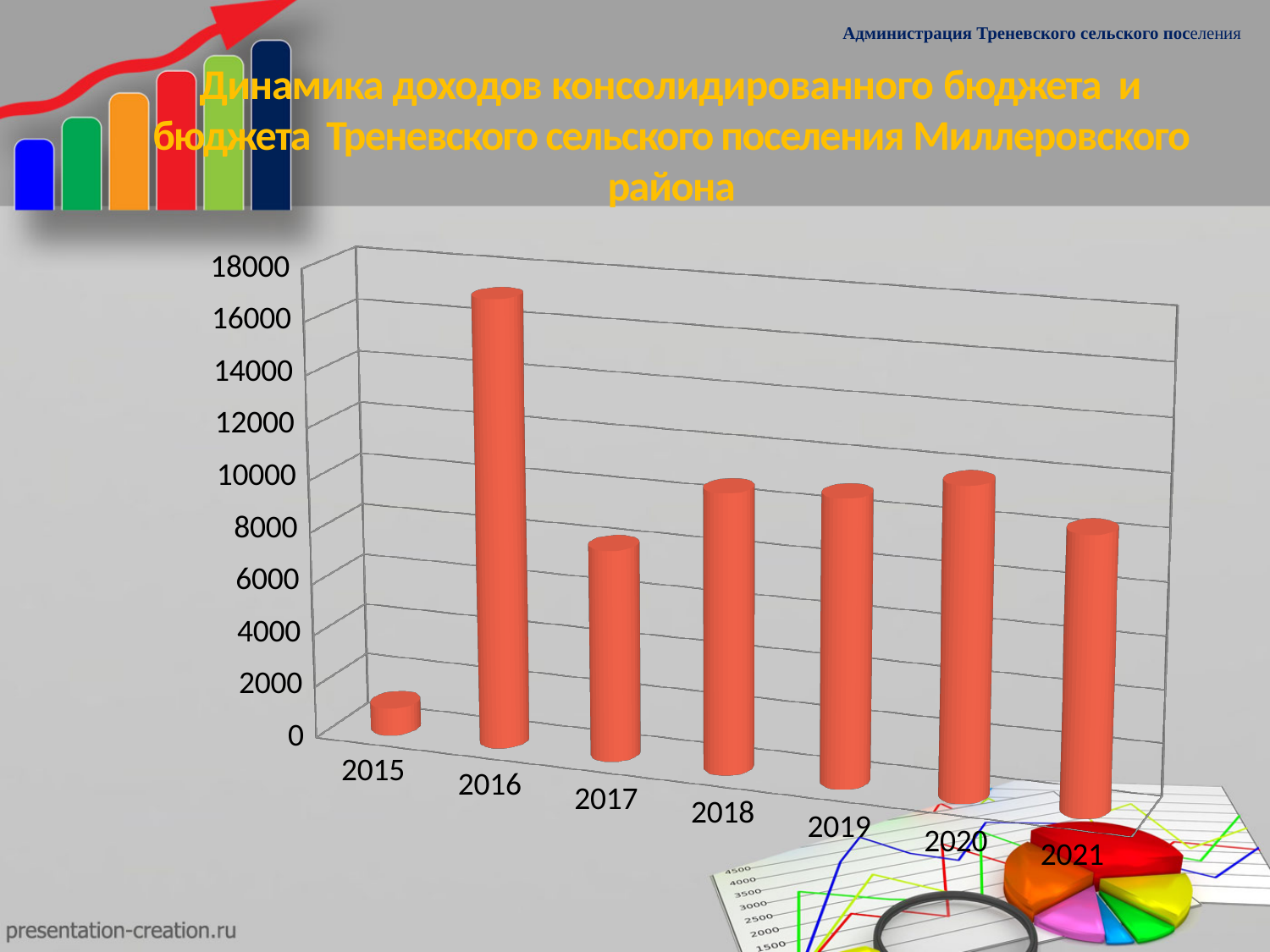
Which is larger, the value for 2016 or the value for 2017? 2016 Does the value rise or fall from 2016 to 2017? fall What is the first year shown on the x axis of the chart? 2015 Is the value for 2020 greater or less than 12000? less What kind of chart is shown on the slide? bar chart How many years are shown on the x axis of the chart? 7 Is the value for 2015 greater or less than 2000? less Which year has the lowest bar in the chart? 2015 Is the value for 2021 greater or less than 6000? greater Which is larger, the value for 2015 or the value for 2021? 2021 Which year has the highest bar in the chart? 2016